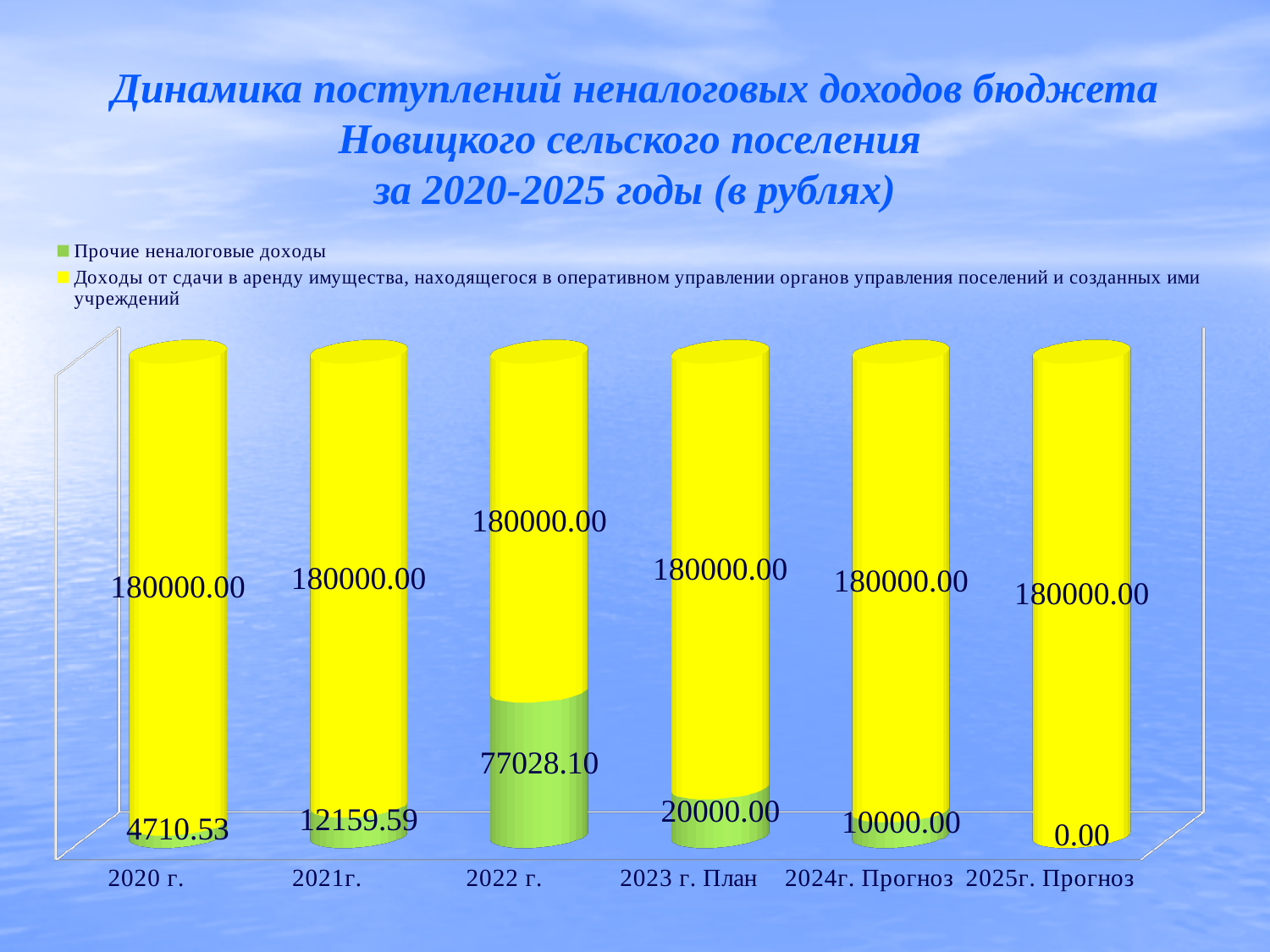
What type of chart is shown on the slide? Stacked bar chart What is the total of the stacked bar for 2022 г.? 257028.10 In which year is Прочие неналоговые доходы lowest? 2025г. Прогноз What is the value of Доходы от сдачи в аренду имущества for 2023 г. План? 180000.00 How many series does the legend list? 2 What is the value of Прочие неналоговые доходы for 2025г. Прогноз? 0.00 What is the value of Прочие неналоговые доходы for 2022 г.? 77028.10 How many categories (years) are shown on the x axis? 6 In which year is Прочие неналоговые доходы highest? 2022 г. What is the value of Прочие неналоговые доходы for 2020 г.? 4710.53 What is the difference between Прочие неналоговые доходы in 2022 г. and 2023 г. План? 57028.10 Which is larger: Прочие неналоговые доходы in 2021г. or in 2024г. Прогноз? 2021г.